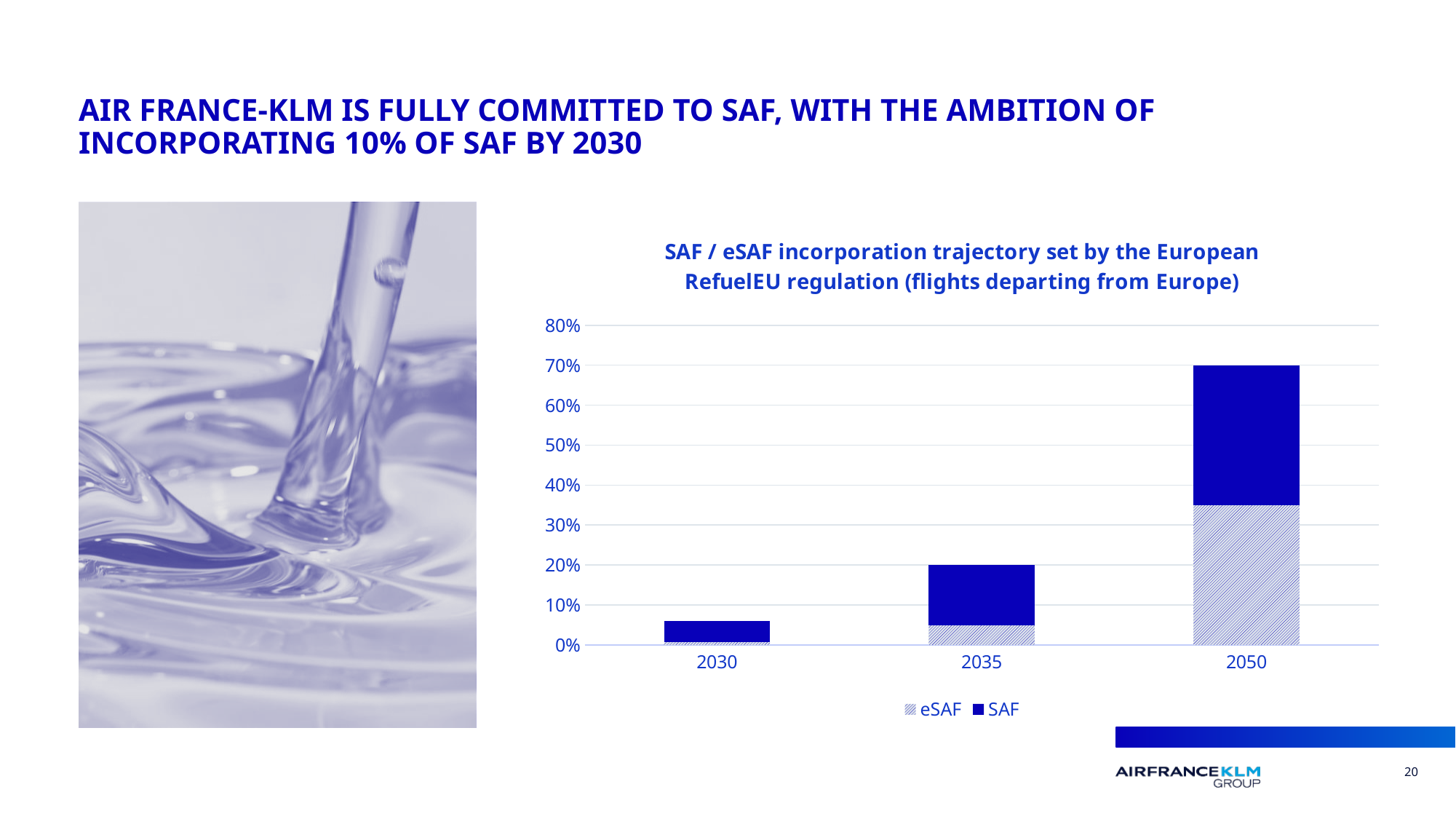
Which year has the highest total bar in the chart? 2050 How many series does the chart's legend list? 2 Which year has a larger total bar, 2035 or 2050? 2050 Do the total bar heights rise or fall from 2030 to 2050? Rise What kind of chart is shown on the slide? Stacked bar chart What is the total height of the stacked bar for 2050? 70% Is the eSAF portion of the 2050 bar greater or less than 30%? greater Which year has the lowest total bar in the chart? 2030 Is the total bar for 2030 greater or less than 10%? less How many years are shown on the x axis of the chart? 3 What is the total height of the stacked bar for 2035? 20% What are the two series named in the chart's legend? eSAF and SAF